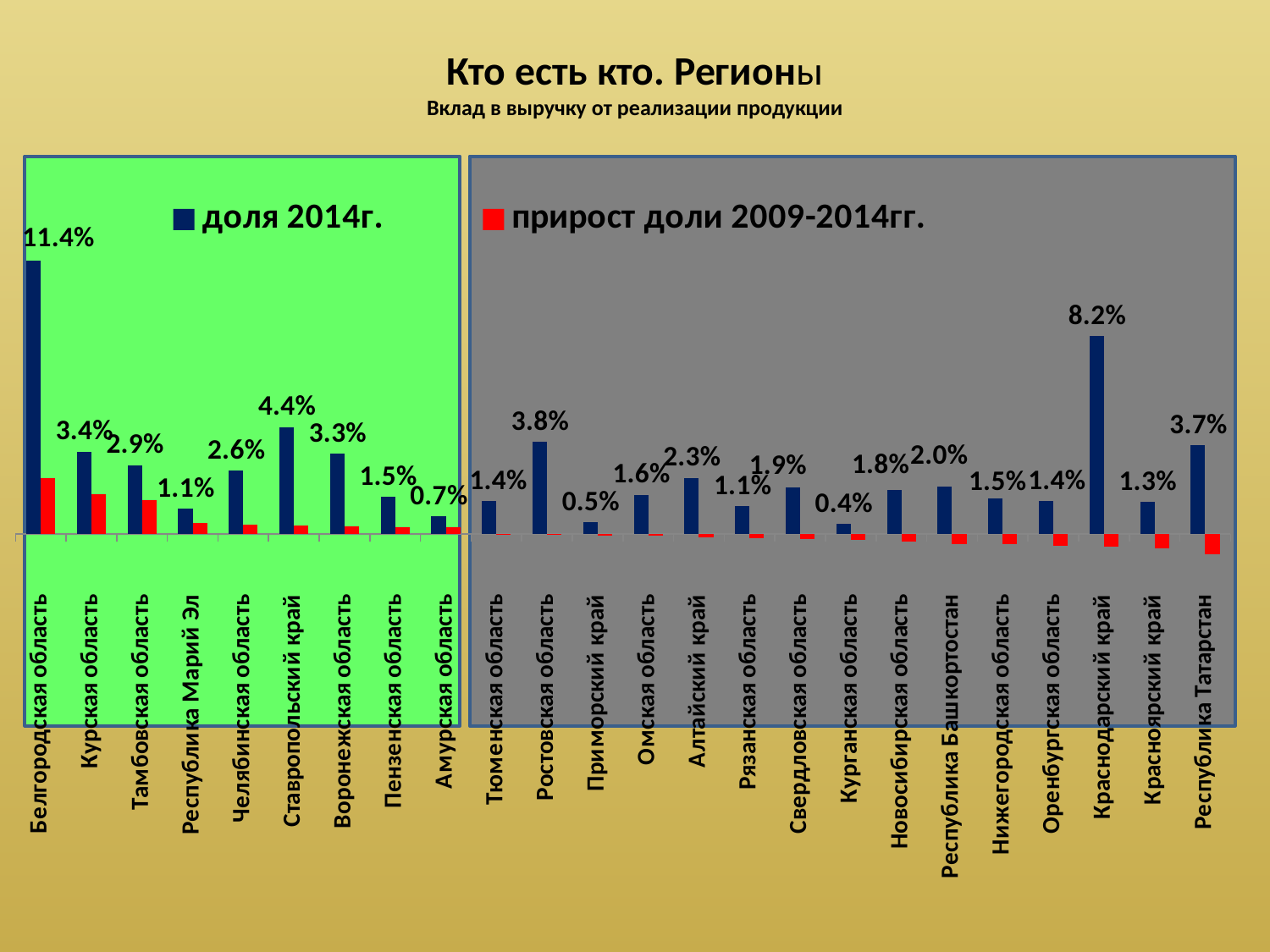
What is the value of "доля 2014г." for Краснодарский край? 8.2% How many series does the chart legend list? 2 Which has a larger "доля 2014г." value, Ставропольский край or Ростовская область? Ставропольский край Which region has the highest "доля 2014г." value? Белгородская область Which series is shown in red in the chart? прирост доли 2009-2014гг. What type of chart is shown on the slide? Bar chart What is the value of "доля 2014г." for Ставропольский край? 4.4% What is the value of "доля 2014г." for Республика Татарстан? 3.7% What is the difference between the "доля 2014г." values for Белгородская область and Краснодарский край? 3.2 percentage points How many regions are shown on the x axis of the chart? 24 Which region has the lowest "доля 2014г." value? Курганская область What is the value of "доля 2014г." for Белгородская область? 11.4%